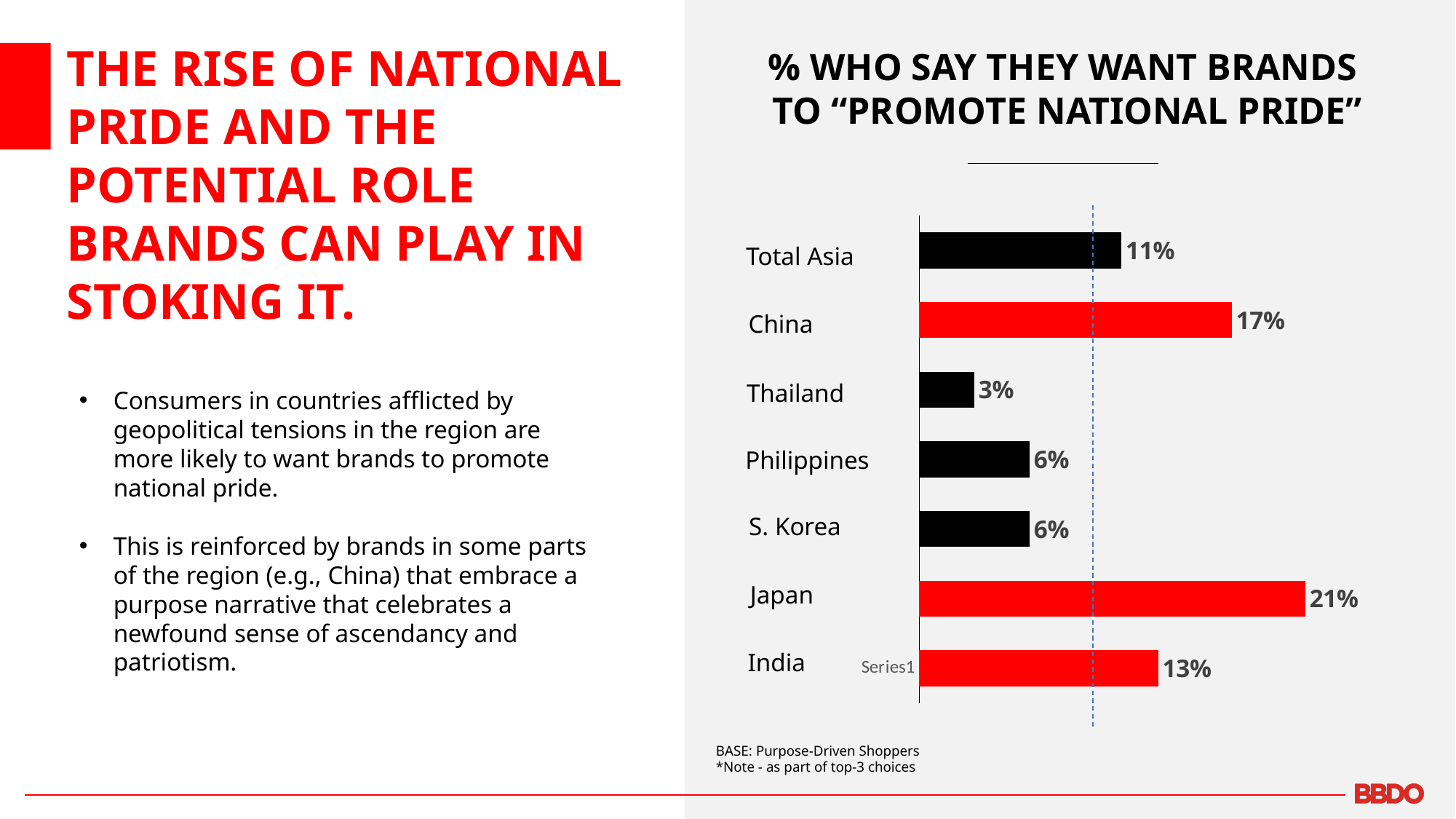
Which country has the highest percentage who want brands to promote national pride? Japan Which country has the lowest percentage who want brands to promote national pride? Thailand What is the title of the chart? % Who Say They Want Brands to "Promote National Pride" Which has a higher value, Total Asia or Philippines? Total Asia What kind of chart is shown on the slide? Bar chart What is the difference between the values for India and Thailand? 10% What is the difference between the values for Japan and China? 4% How many categories are shown on the chart? 7 Which has a higher value, China or India? China What percentage of respondents in China say they want brands to promote national pride? 17% What is the value shown for Total Asia? 11% What is the value shown for India? 13%